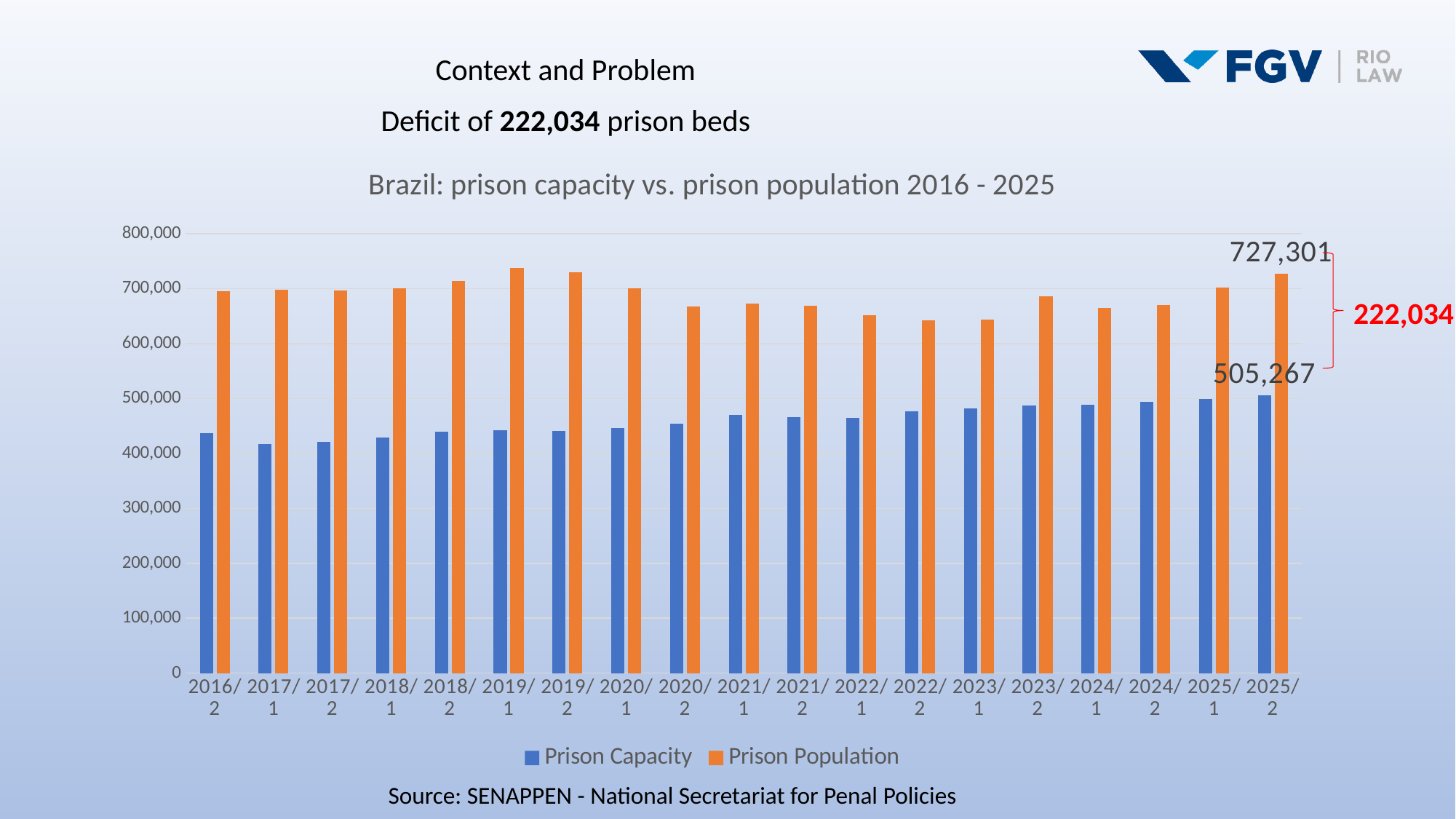
What is the prison capacity value for 2025/2? 505,267 Is the prison capacity value for 2021/1 greater or less than 500,000? less Is the prison population value for 2019/1 greater or less than 700,000? greater Does prison capacity generally rise or fall from 2016/2 to 2025/2? rise What is the title of the chart? Brazil: prison capacity vs. prison population 2016 - 2025 In which period is prison capacity the lowest? 2017/1 How many periods are shown on the x axis? 19 What is the difference between prison population and prison capacity in 2025/2? 222,034 What type of chart is shown on the slide? bar chart What is the prison population value for 2025/2? 727,301 How many series does the legend list? 2 In which period is prison capacity the highest? 2025/2